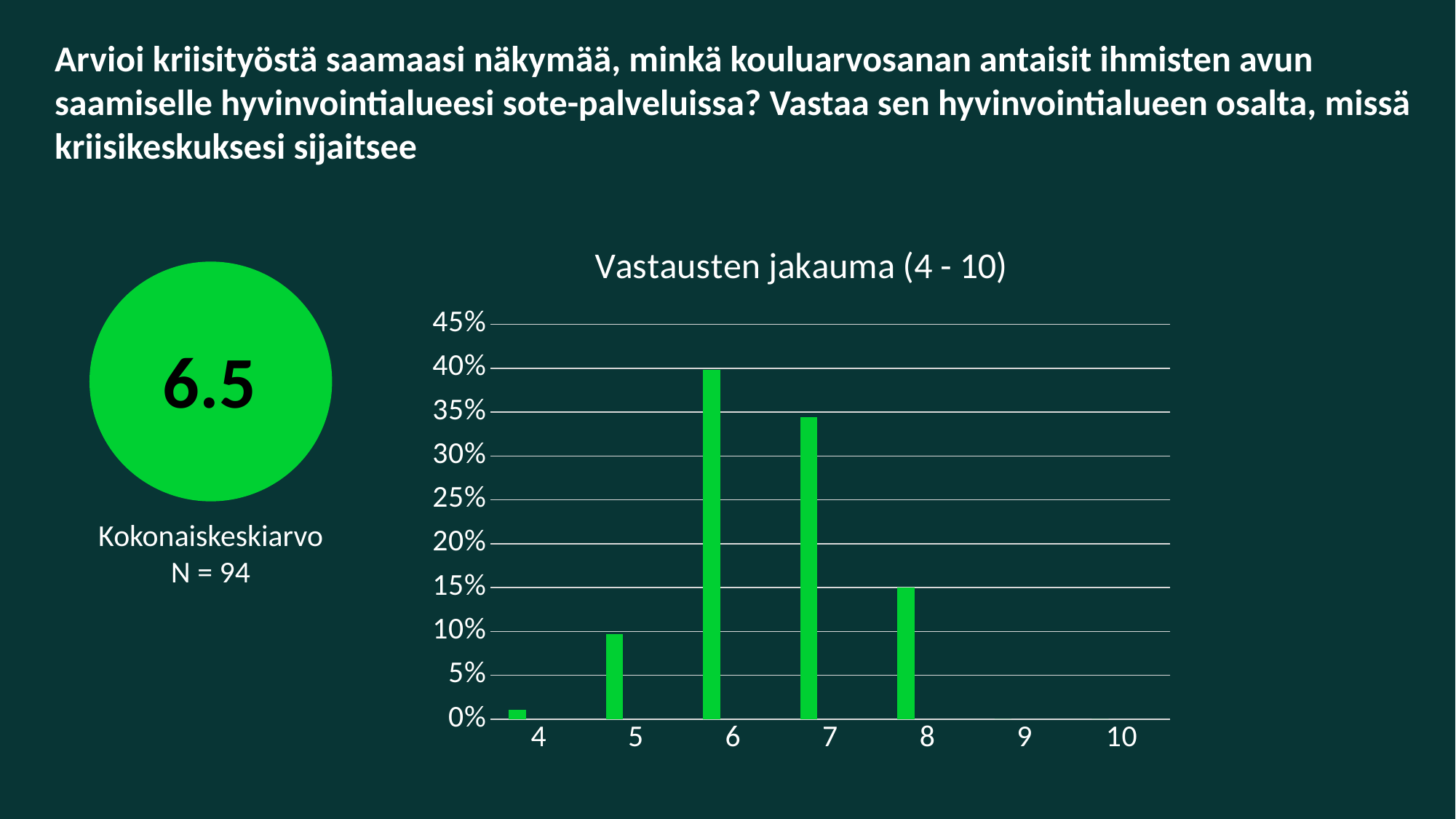
Among the categories 4 to 8, which has the shortest bar? 4 Is the value for category 8 greater or less than 20%? less Is the value for category 4 greater or less than 5%? less Which has the larger value, category 5 or category 8? 8 Is the value for category 7 greater or less than 30%? greater Which category has the tallest bar in the chart? 6 How many categories are shown on the x axis of the chart? 7 What is the title of the chart? Vastausten jakauma (4 - 10) Which has the larger value, category 6 or category 7? 6 What kind of chart is shown on the slide? bar chart